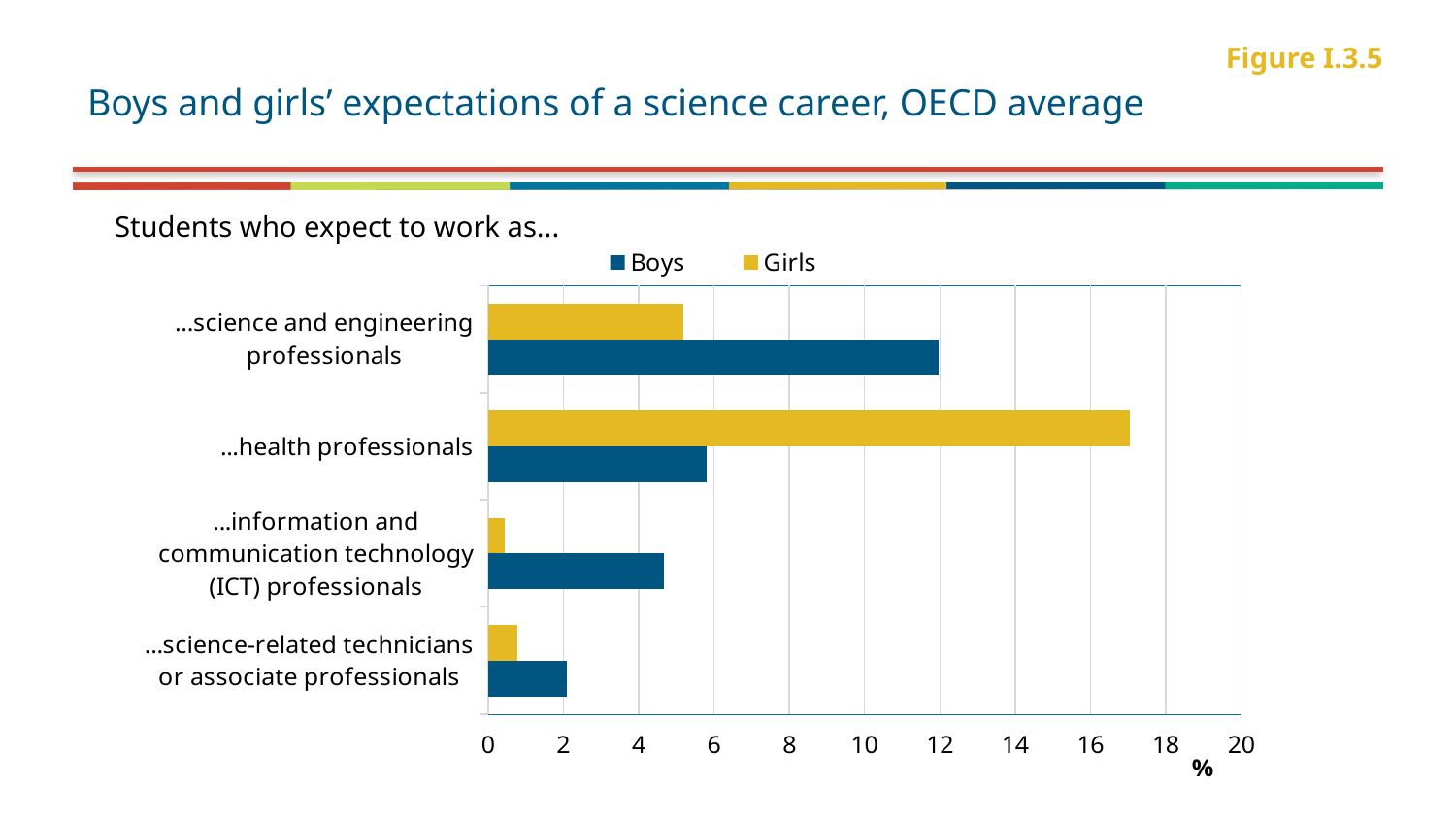
For science and engineering professionals, which is larger, the value for Boys or the value for Girls? Boys For health professionals, which is larger, the value for Boys or the value for Girls? Girls Which career category has the lowest value for Girls? ...information and communication technology (ICT) professionals Which career category has the highest value for Girls? ...health professionals Which career category has the highest value for Boys? ...science and engineering professionals What is the title of the chart on the slide? Boys and girls' expectations of a science career, OECD average Is the value for Girls who expect to work as health professionals greater or less than 16? greater Which career category has the lowest value for Boys? ...science-related technicians or associate professionals How many series does the legend list? 2 How many career categories are shown on the chart? 4 Is the value for Boys who expect to work as ICT professionals greater or less than 6? less What kind of chart is shown on the slide? bar chart